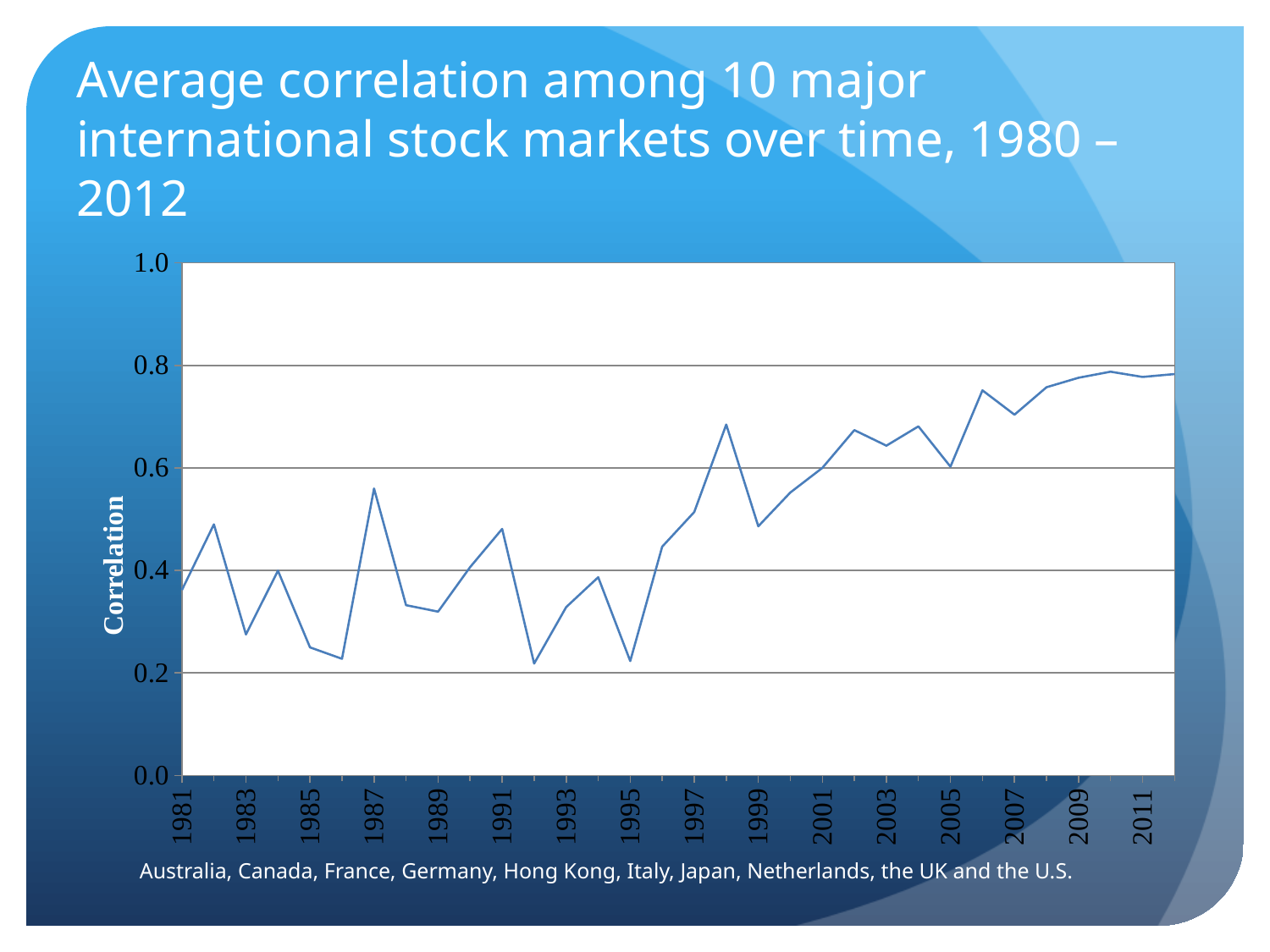
Is the value for 1981 greater or less than 0.4? less Which year has the larger value, 1987 or 1981? 1987 Which year has the larger value, 1995 or 2009? 2009 How many lines are plotted on the chart? 1 Is the value for 1987 greater or less than 0.4? greater What kind of chart is shown on the slide? line chart Is the value for 2009 greater or less than 0.8? less What is the label on the vertical axis of the chart? Correlation Overall, does the average correlation rise or fall from 1981 to 2012? rise What is the title of the chart on the slide? Average correlation among 10 major international stock markets over time, 1980 – 2012